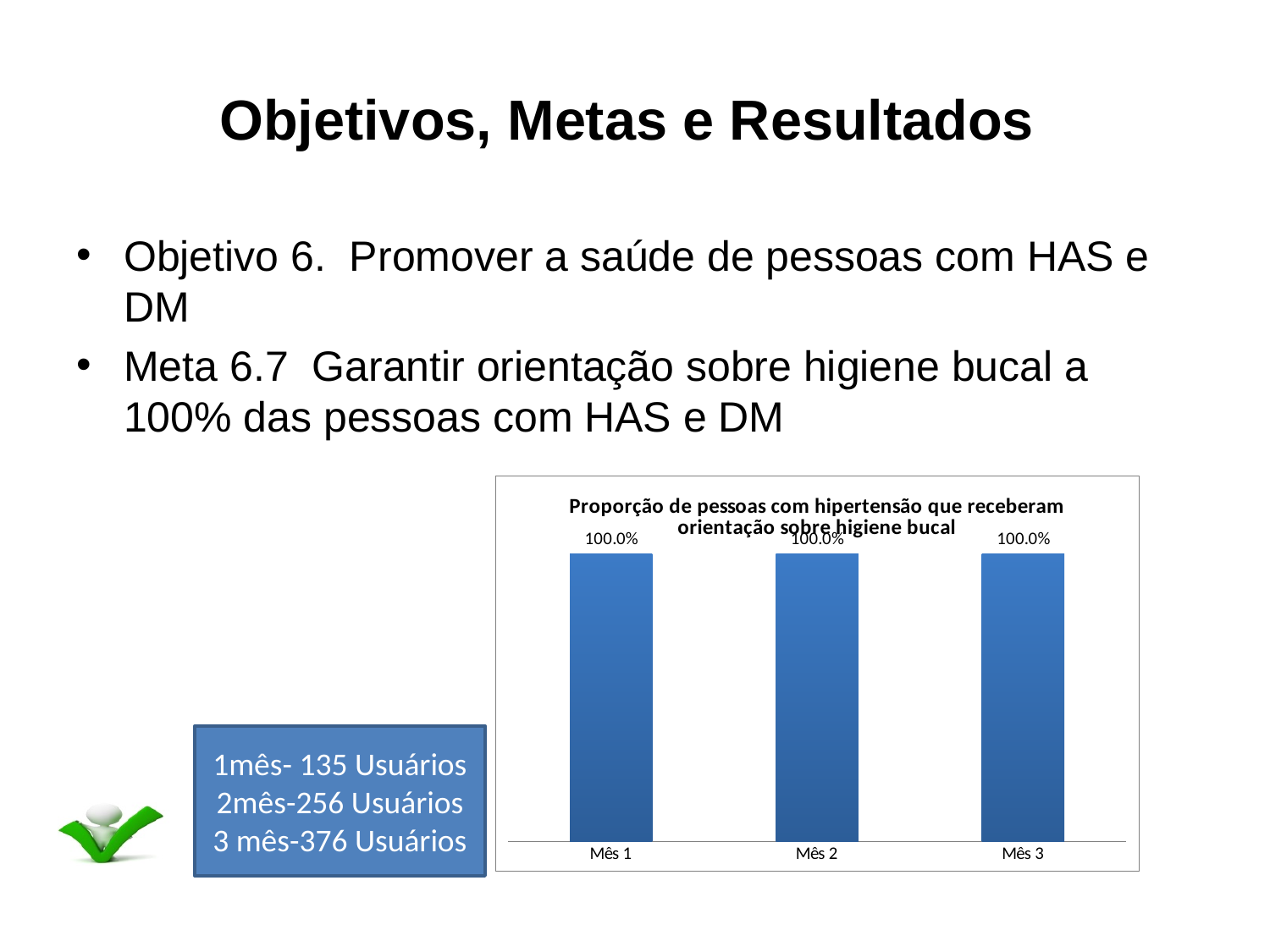
What is the difference between the values for Mês 1 and Mês 3? 0.0% What is the difference between the values for Mês 2 and Mês 1? 0.0% What colour are the bars in the chart? Blue What is the label of the first category on the x axis? Mês 1 What is the value for Mês 2 in the chart? 100.0% What is the value for Mês 1 in the chart? 100.0% How many categories (months) are shown on the x axis of the chart? 3 What is the title of the chart? Proporção de pessoas com hipertensão que receberam orientação sobre higiene bucal What kind of chart is shown on the slide? Bar chart Do the values rise, fall, or stay the same from Mês 1 to Mês 3? Stay the same What is the value for Mês 3 in the chart? 100.0%